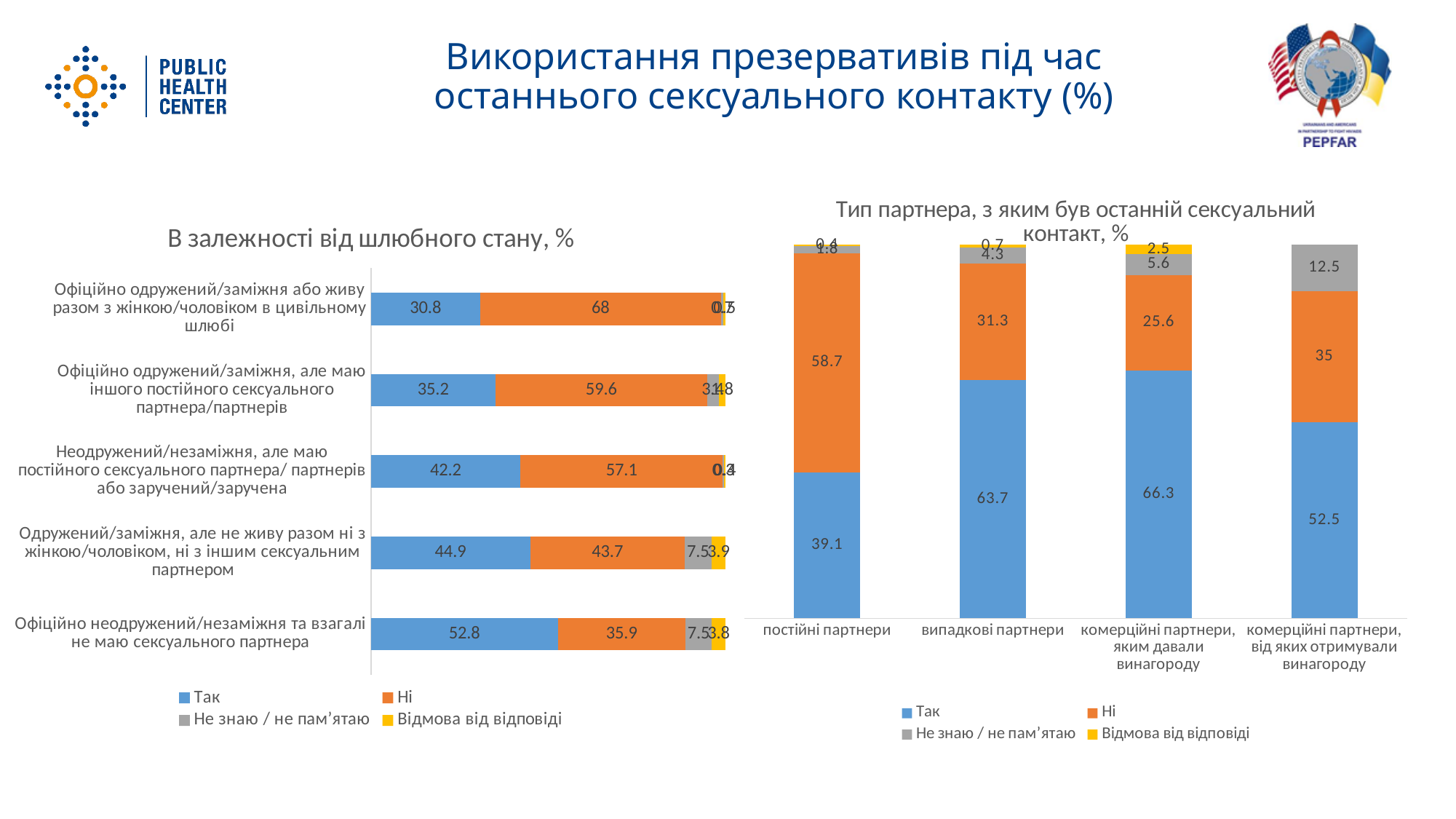
In the chart 'Тип партнера, з яким був останній сексуальний контакт, %', what is the 'Так' value for 'випадкові партнери'? 63.7 In the chart 'Тип партнера, з яким був останній сексуальний контакт, %', what is the 'Ні' value for 'постійні партнери'? 58.7 In the chart 'В залежності від шлюбного стану, %', is the 'Так' value larger for 'Неодружений/незаміжня, але маю постійного сексуального партнера/ партнерів або заручений/заручена' or for 'Офіційно одружений/заміжня, але маю іншого постійного сексуального партнера/партнерів'? Неодружений/незаміжня, але маю постійного сексуального партнера/ партнерів або заручений/заручена In the chart 'Тип партнера, з яким був останній сексуальний контакт, %', what is the difference between the 'Так' values for 'комерційні партнери, яким давали винагороду' and 'постійні партнери'? 27.2 In the chart 'В залежності від шлюбного стану, %', what is the 'Ні' value for 'Офіційно одружений/заміжня або живу разом з жінкою/чоловіком в цивільному шлюбі'? 68 In the chart 'В залежності від шлюбного стану, %', how many series does the legend list? 4 In the chart 'В залежності від шлюбного стану, %', which marital status category has the lowest 'Так' value? Офіційно одружений/заміжня або живу разом з жінкою/чоловіком в цивільному шлюбі In the chart 'Тип партнера, з яким був останній сексуальний контакт, %', what is the 'Не знаю / не пам’ятаю' value for 'комерційні партнери, від яких отримували винагороду'? 12.5 In the chart 'В залежності від шлюбного стану, %', what is the 'Так' value for 'Офіційно неодружений/незаміжня та взагалі не маю сексуального партнера'? 52.8 In the chart 'Тип партнера, з яким був останній сексуальний контакт, %', how many partner types are shown? 4 What type of chart is 'В залежності від шлюбного стану, %'? Stacked bar chart In the chart 'Тип партнера, з яким був останній сексуальний контакт, %', which partner type has the highest 'Так' value? комерційні партнери, яким давали винагороду